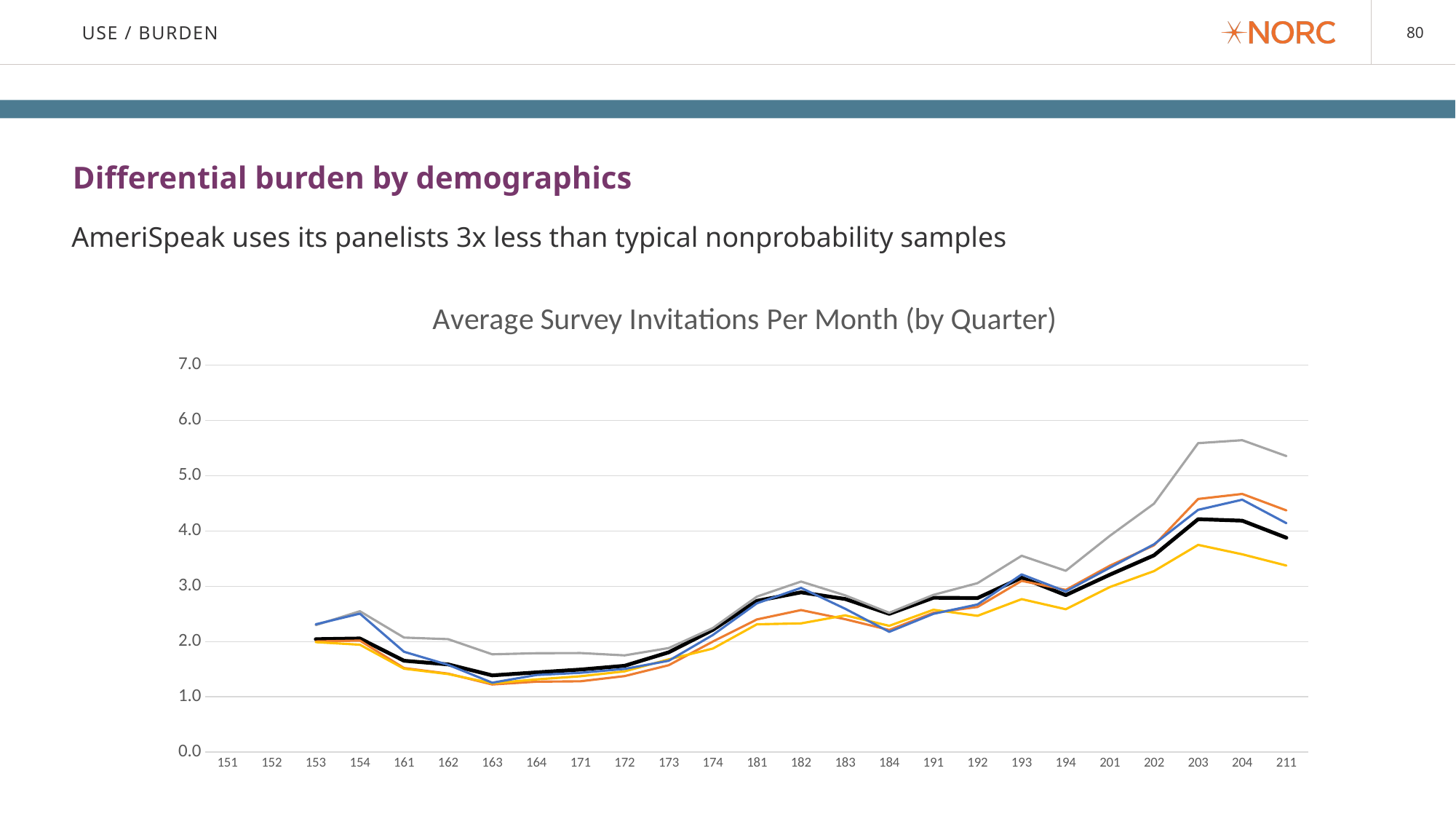
How many lines are plotted on the chart? 5 Is the value of the orange line at 203 greater or less than 4.0? greater Is the value of the gray line at 204 greater or less than 5.0? greater Which line is highest at quarter 204? the gray line Which line is lowest at quarter 211? the yellow line At quarter 211, is the gray line or the yellow line higher? the gray line Is the value of the black line at 211 greater or less than 3.0? greater What kind of chart is shown on the slide? line chart What is the title of the chart? Average Survey Invitations Per Month (by Quarter) Do the lines generally rise or fall between quarters 191 and 203? rise How many category labels are shown on the x axis? 25